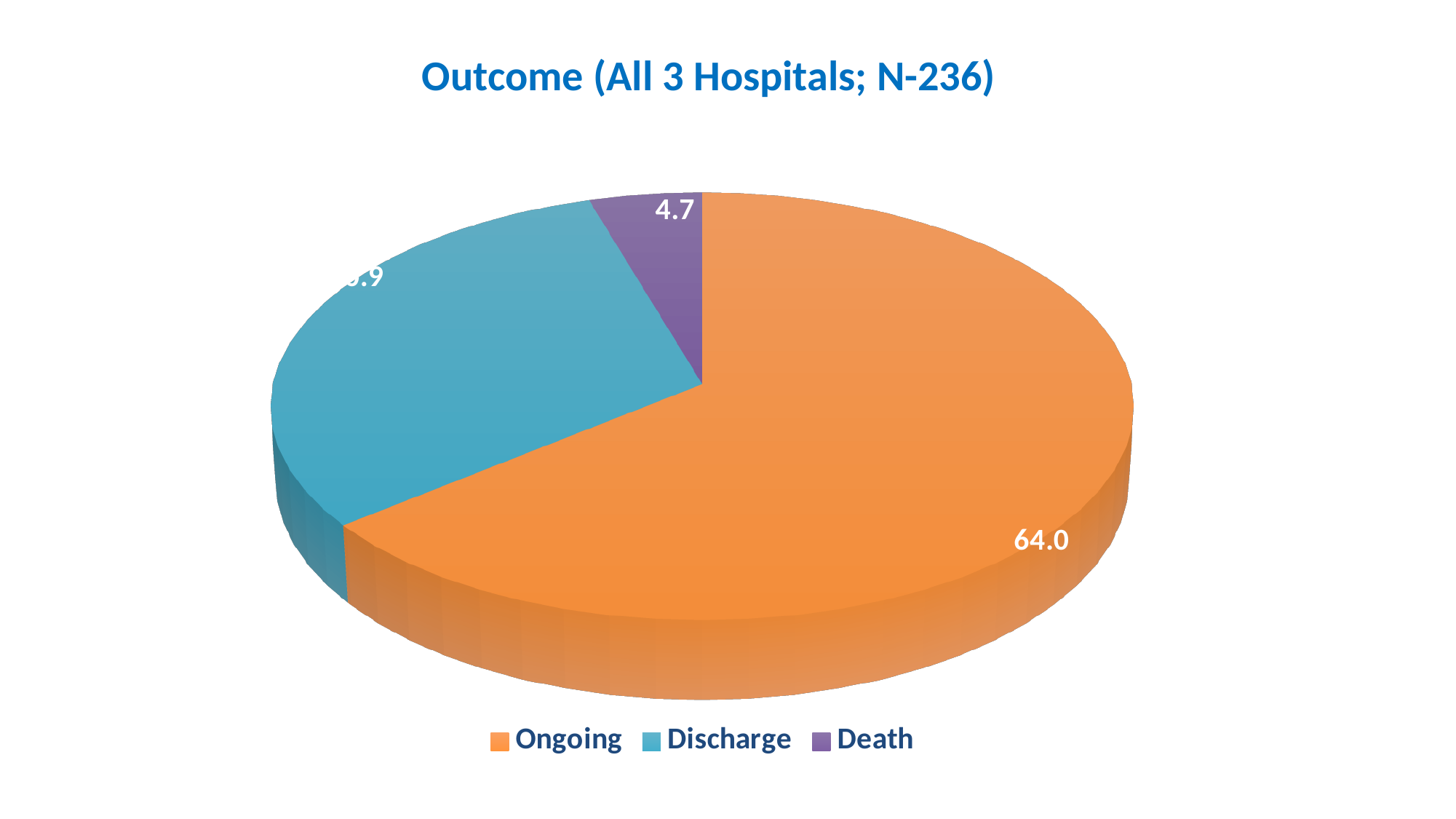
What is the value shown for the Death slice? 4.7 What is the value shown for the Ongoing slice? 64.0 How many categories are shown in the pie chart? 3 Which outcome category has the smallest slice of the pie? Death What is the title of the chart? Outcome (All 3 Hospitals; N-236) What kind of chart is shown on the slide? Pie chart How many entries does the legend list? 3 Which slice is larger, Discharge or Death? Discharge Which outcome category has the largest slice of the pie? Ongoing What is the difference between the Ongoing value and the Death value? 59.3 Which colour represents the Discharge category in the legend? Blue Which slice is larger, Ongoing or Discharge? Ongoing